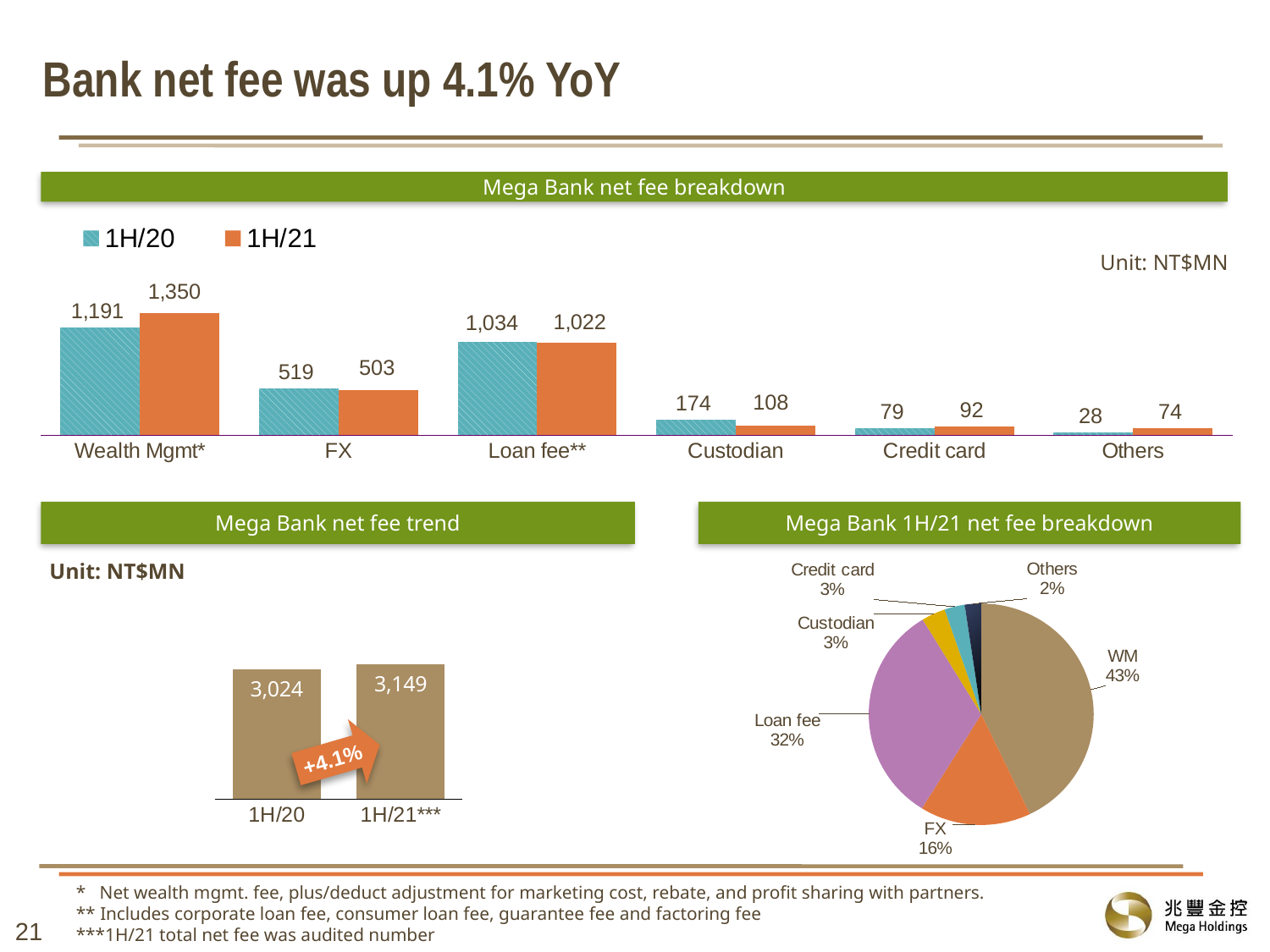
In the 'Mega Bank net fee breakdown' chart, is the 1H/20 value for FX larger or smaller than the 1H/21 value for FX? larger In the 'Mega Bank net fee breakdown' chart, what is the 1H/20 value for Custodian? 174 In the 'Mega Bank net fee trend' chart, what is the difference between the 1H/21*** and 1H/20 values? 125 In the 'Mega Bank net fee trend' chart, what is the value for 1H/21***? 3,149 In the 'Mega Bank net fee breakdown' chart, which category has the highest 1H/21 value? Wealth Mgmt* How many series does the legend of the 'Mega Bank net fee breakdown' chart list? 2 In the 'Mega Bank net fee breakdown' chart, what is the 1H/21 value for Wealth Mgmt*? 1,350 What kind of chart is the 'Mega Bank 1H/21 net fee breakdown' chart? pie chart In the 'Mega Bank 1H/21 net fee breakdown' chart, what share does Loan fee have? 32% How many categories are shown on the x axis of the 'Mega Bank net fee breakdown' chart? 6 In the 'Mega Bank net fee breakdown' chart, what is the difference between the 1H/21 and 1H/20 values for Wealth Mgmt*? 159 In the 'Mega Bank net fee breakdown' chart, which category has the lowest 1H/20 value? Others